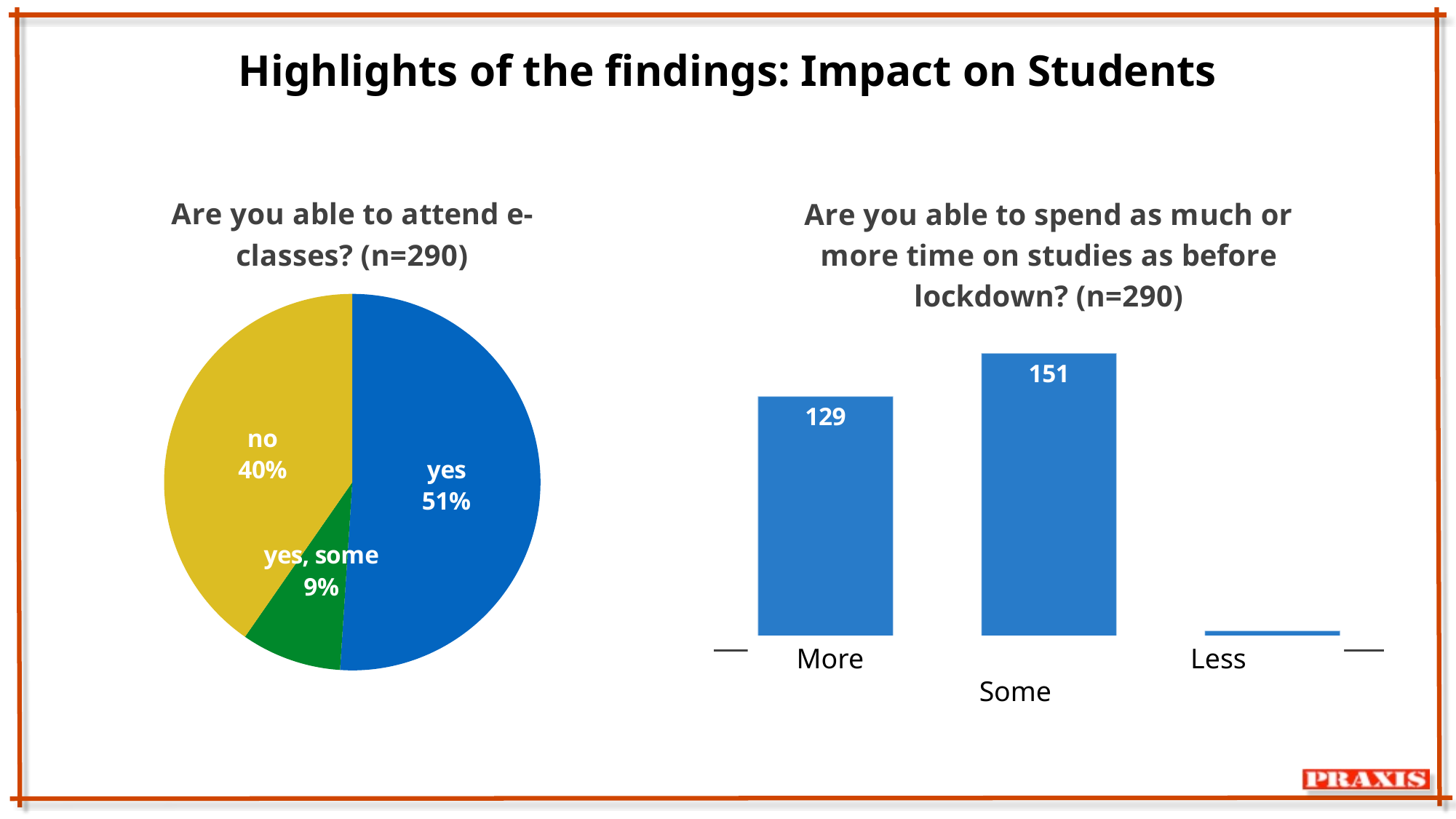
In the bar chart 'Are you able to spend as much or more time on studies as before lockdown?', what is the difference between the values for 'Some' and 'More'? 22 In the pie chart 'Are you able to attend e-classes?', how many slices are there? 3 In the pie chart 'Are you able to attend e-classes?', which response has the smallest slice? yes, some What type of chart is the right chart, 'Are you able to spend as much or more time on studies as before lockdown?'? bar chart What type of chart is the left chart, 'Are you able to attend e-classes?'? pie chart In the pie chart 'Are you able to attend e-classes?', what share of respondents answered 'yes, some'? 9% In the pie chart 'Are you able to attend e-classes?', which response has the largest slice? yes In the bar chart 'Are you able to spend as much or more time on studies as before lockdown?', what is the value for 'Some'? 151 In the pie chart 'Are you able to attend e-classes?', what share of respondents answered 'yes'? 51% In the bar chart 'Are you able to spend as much or more time on studies as before lockdown?', what is the value for 'More'? 129 In the pie chart 'Are you able to attend e-classes?', what share of respondents answered 'no'? 40% In the bar chart 'Are you able to spend as much or more time on studies as before lockdown?', which category has the highest value? Some